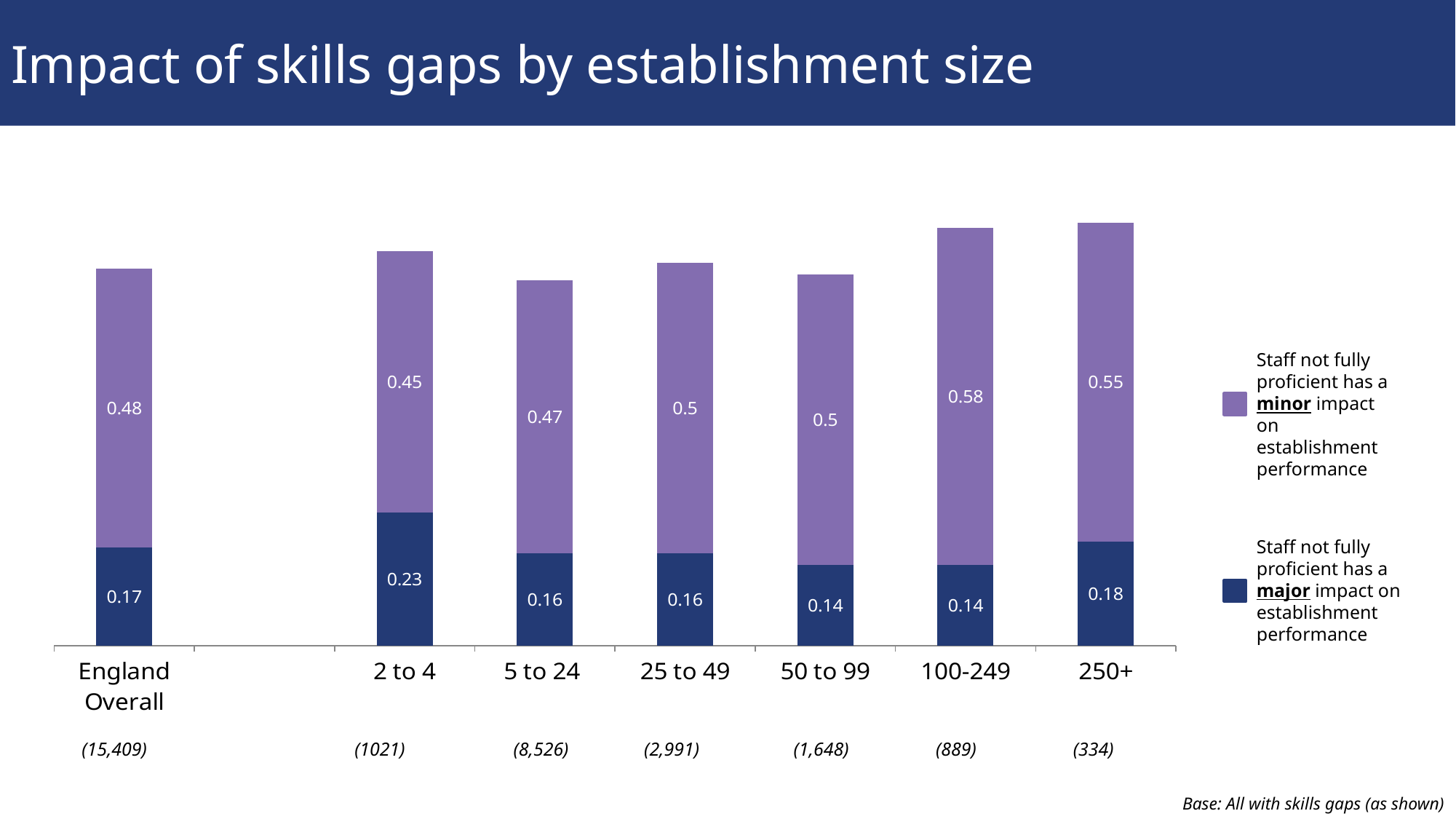
What is the 'major impact' value for England Overall? 0.17 How many establishment size categories are shown on the x axis, including England Overall? 7 Which establishment size has the highest 'minor impact' value? 100-249 What is the value for the 'major impact' series for the 2 to 4 establishment size? 0.23 What is the value for the 'minor impact' series for the 100-249 establishment size? 0.58 Which establishment size has the lowest 'minor impact' value? 2 to 4 What is the difference between the 'minor impact' values for 250+ and England Overall? 0.07 Is the 'major impact' value larger for 250+ or for 5 to 24? 250+ How many series does the legend list? 2 What is the total of the stacked bar for the 250+ establishment size? 0.73 What kind of chart is shown on the slide? Stacked bar chart Which establishment size has the highest 'major impact' value? 2 to 4